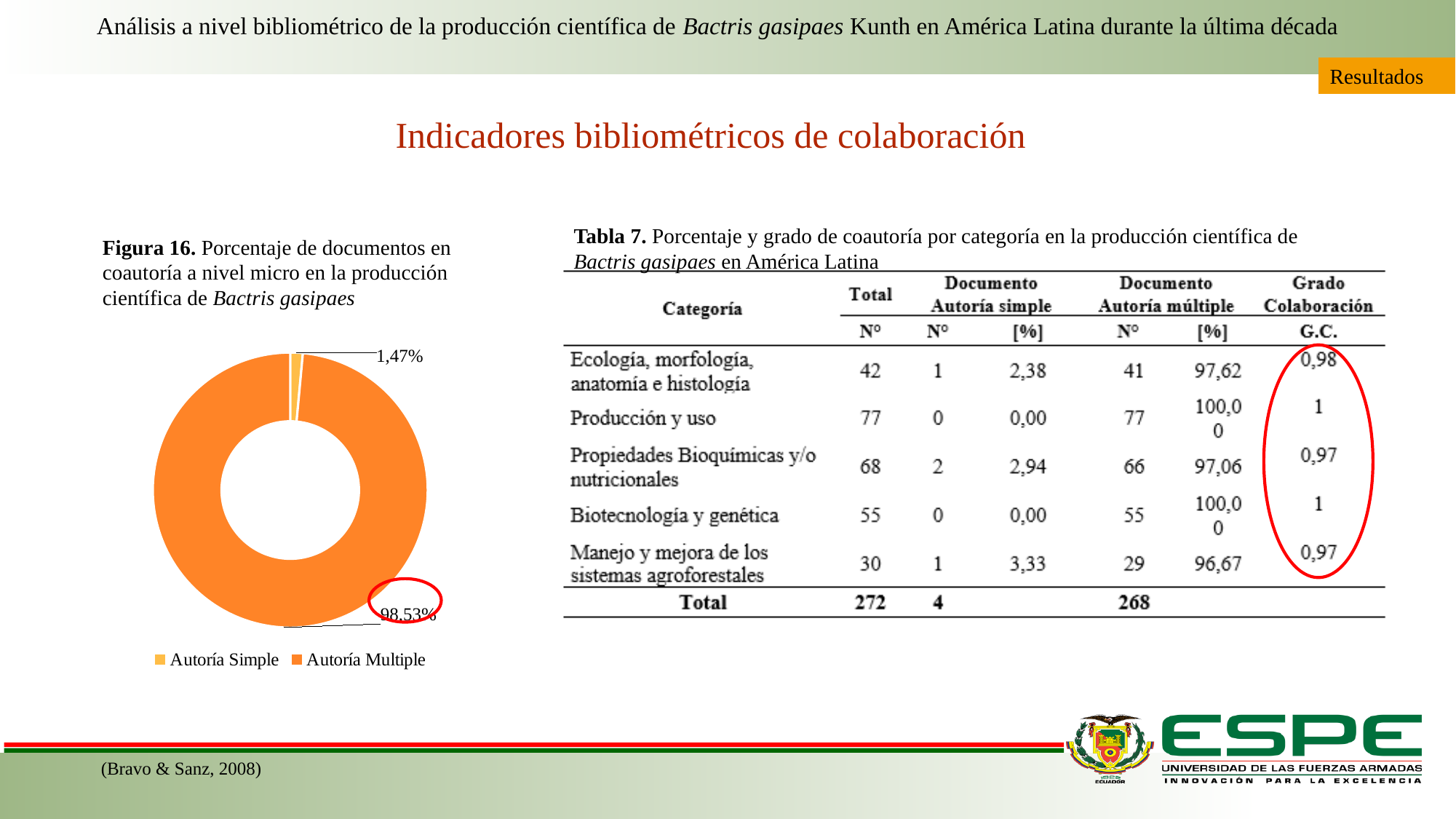
What kind of chart is Figura 16? Pie chart (donut) In Figura 16, which is larger, Autoría Simple or Autoría Multiple? Autoría Multiple How many categories are shown in the Figura 16 chart? 2 In Figura 16, what is the difference in percentage points between Autoría Multiple and Autoría Simple? 97,06 In Figura 16, what colour is the Autoría Multiple slice? Orange In Figura 16, which category has the smallest share? Autoría Simple In Figura 16, what colour is the Autoría Simple slice? Yellow In Figura 16, which category has the largest share? Autoría Multiple In Figura 16, what percentage is shown for Autoría Multiple? 98,53% How many entries does the legend of Figura 16 list? 2 In Figura 16, what share of the chart does the Autoría Multiple slice represent? 98,53% In Figura 16, what percentage is shown for Autoría Simple? 1,47%